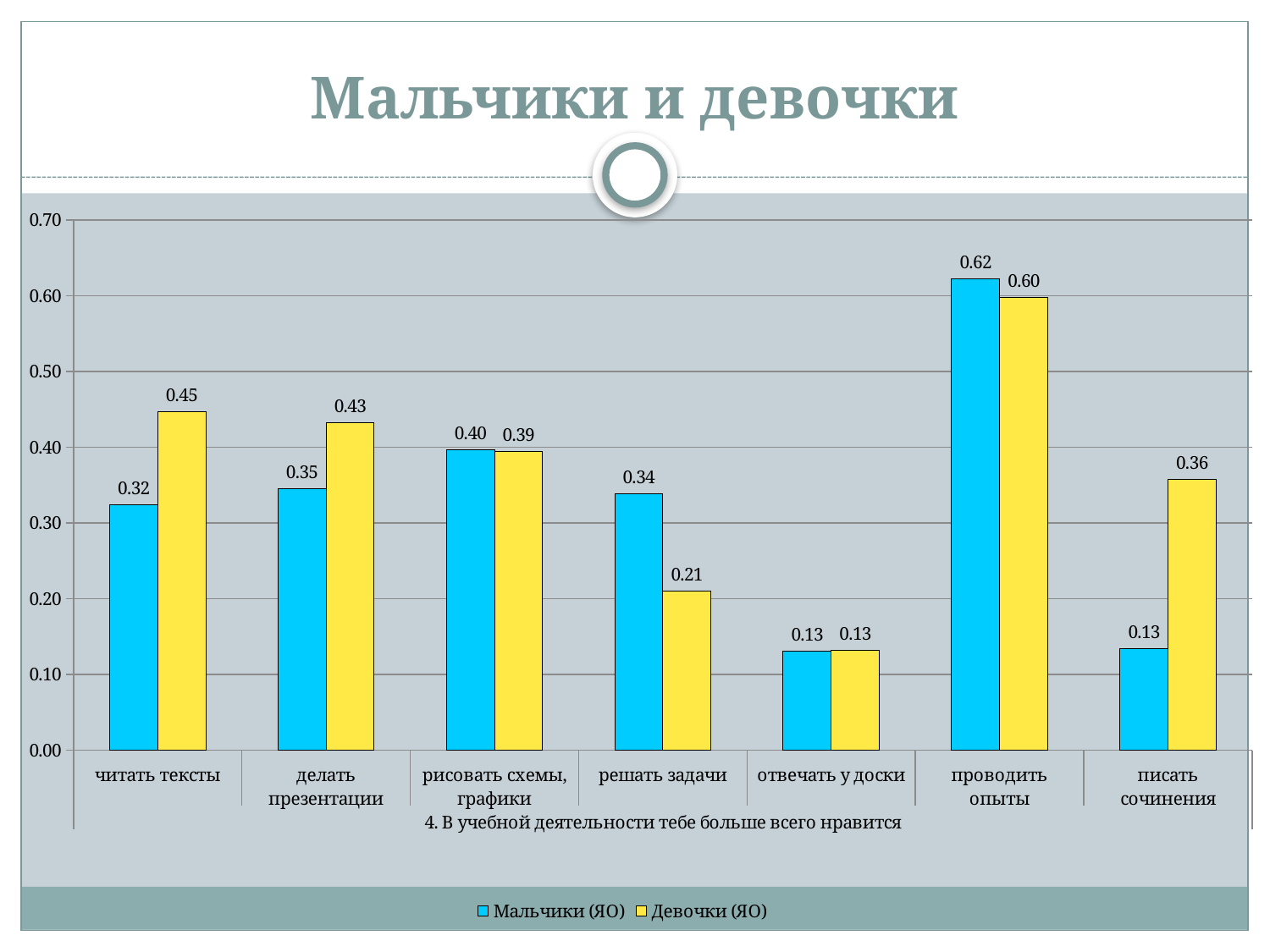
Which is larger for 'делать презентации': the value for Мальчики (ЯО) or for Девочки (ЯО)? Девочки (ЯО) How many series does the legend list? 2 What is the value for Девочки (ЯО) in the category 'решать задачи'? 0.21 Is the value for Мальчики (ЯО) in 'проводить опыты' greater or less than 0.50? greater What is the value for Девочки (ЯО) in the category 'писать сочинения'? 0.36 What is the difference between the Мальчики (ЯО) and Девочки (ЯО) values for 'решать задачи'? 0.13 How many categories are shown on the x axis? 7 Which category has the highest value for Мальчики (ЯО)? проводить опыты What is the difference between the Девочки (ЯО) and Мальчики (ЯО) values for 'писать сочинения'? 0.23 Which category has the lowest value for Девочки (ЯО)? отвечать у доски What kind of chart is shown on the slide? bar chart What is the value for Мальчики (ЯО) in the category 'читать тексты'? 0.32